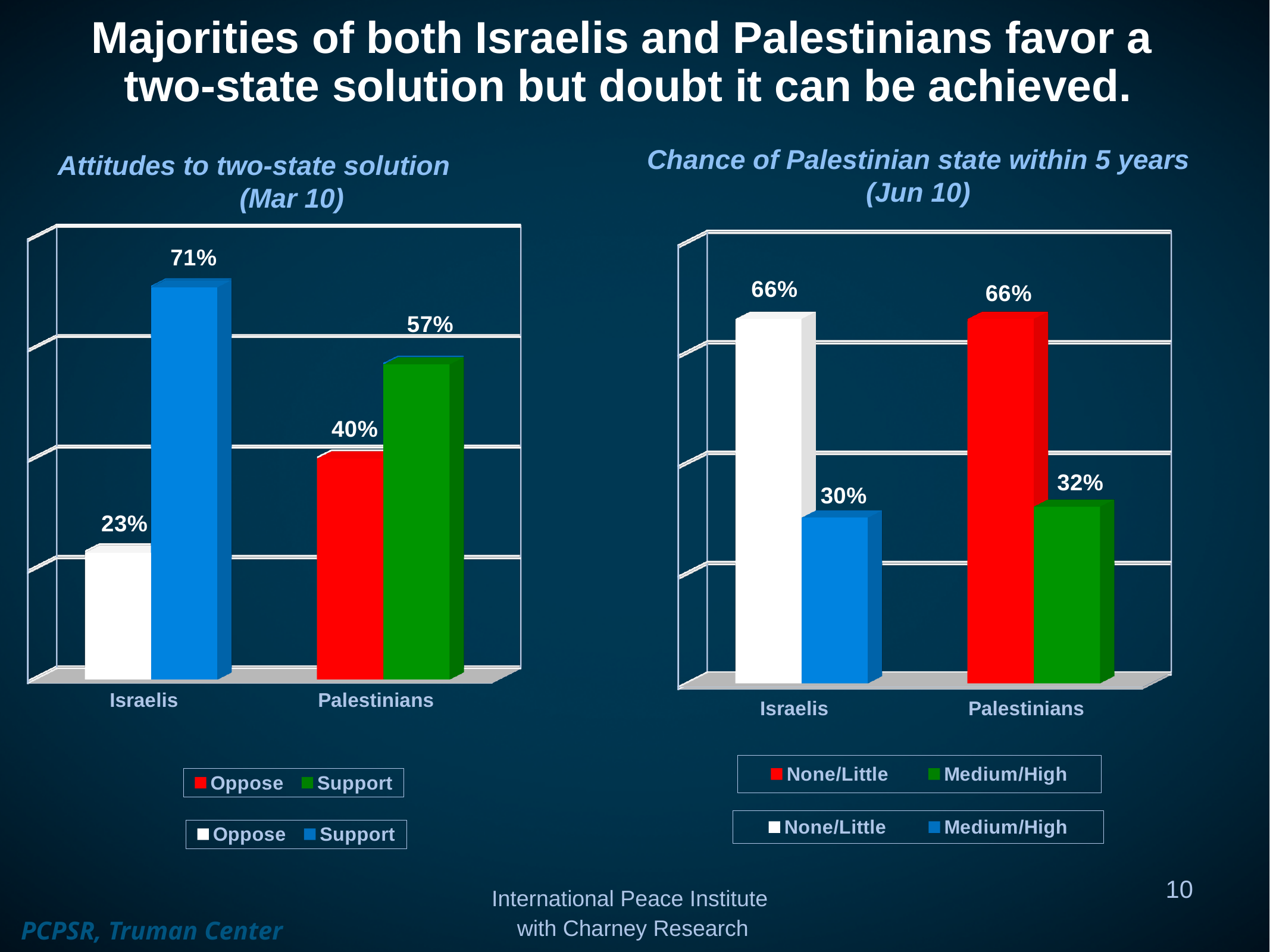
How many groups of respondents are shown on the x axis of the 'Chance of Palestinian state within 5 years (Jun 10)' chart? 2 In the 'Attitudes to two-state solution (Mar 10)' chart, what percentage of Israelis oppose a two-state solution? 23% In the 'Chance of Palestinian state within 5 years (Jun 10)' chart, what is the difference between Israelis' None/Little and Medium/High values? 36% In the 'Chance of Palestinian state within 5 years (Jun 10)' chart, what percentage of Israelis see None/Little chance? 66% In the 'Attitudes to two-state solution (Mar 10)' chart, what is the difference between Israeli support and Palestinian support? 14% In the 'Attitudes to two-state solution (Mar 10)' chart, which is larger: Palestinian oppose or Palestinian support? Support In the 'Attitudes to two-state solution (Mar 10)' chart, what percentage of Palestinians oppose a two-state solution? 40% In the 'Chance of Palestinian state within 5 years (Jun 10)' chart, what percentage of Palestinians see a Medium/High chance? 32% In the 'Attitudes to two-state solution (Mar 10)' chart, which bar is the highest? Israelis Support (71%) In the 'Attitudes to two-state solution (Mar 10)' chart, what percentage of Israelis support a two-state solution? 71% In the 'Chance of Palestinian state within 5 years (Jun 10)' chart, which bar is the lowest? Israelis Medium/High (30%) What type of chart is the 'Attitudes to two-state solution (Mar 10)' chart? Bar chart